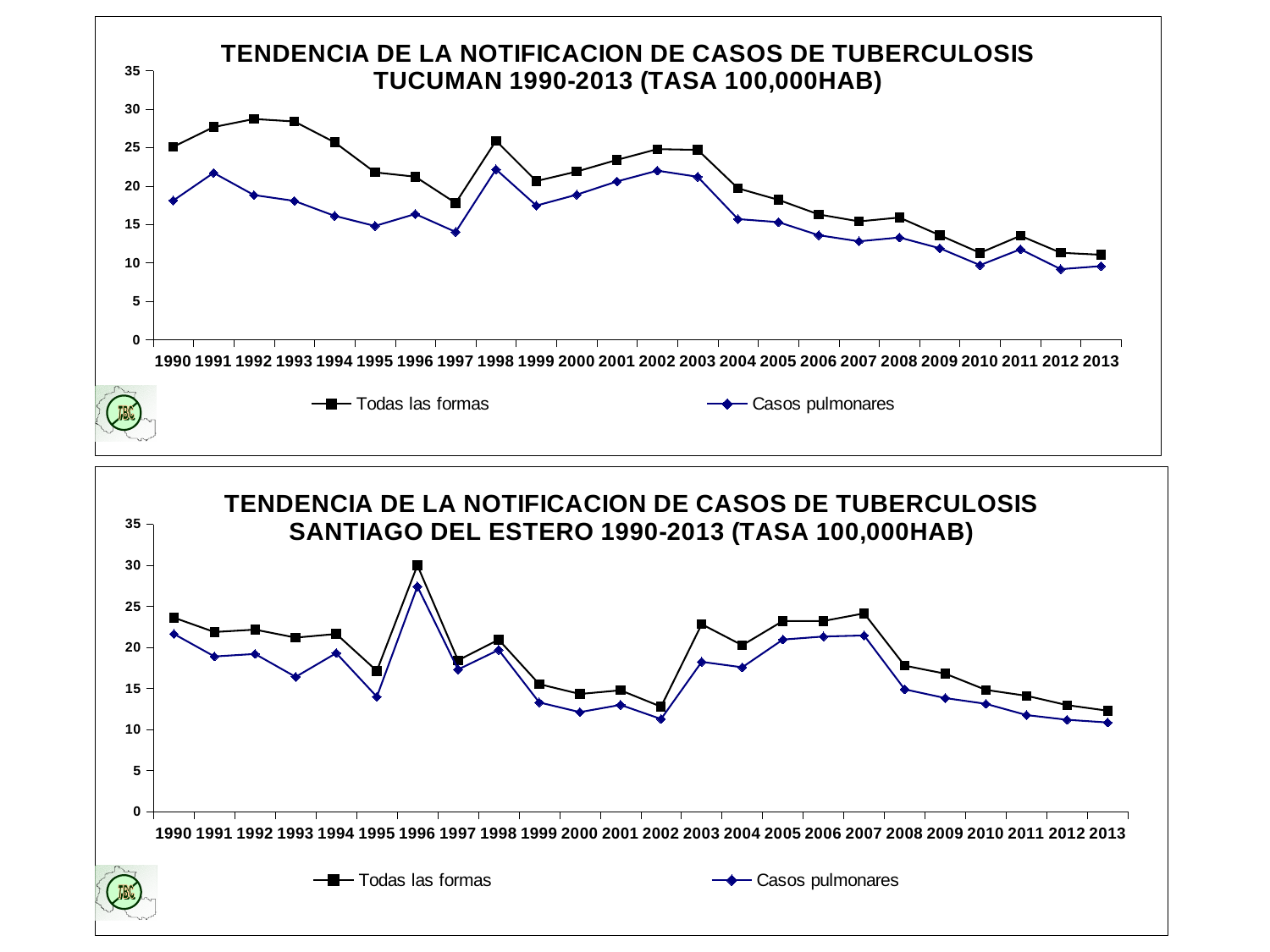
In the bottom chart (Santiago del Estero), do the values for Todas las formas rise or fall from 2007 to 2013? fall In the top chart (Tucuman), is the value for Todas las formas in 1992 greater or less than 25? greater In the top chart (Tucuman), is the value for Casos pulmonares in 1991 greater or less than 20? greater In the bottom chart (Santiago del Estero), which year has the highest value for Todas las formas? 1996 In the bottom chart (Santiago del Estero), is the value for Todas las formas in 2002 greater or less than 15? less How many series does the legend of the bottom chart (Santiago del Estero) list? 2 How many years are plotted along the x axis of the top chart (Tucuman)? 24 In the top chart (Tucuman), which is larger for Todas las formas: the value in 1992 or the value in 2013? 1992 What kind of chart is the top chart (Tucuman)? line chart In the bottom chart (Santiago del Estero), which year has the highest value for Casos pulmonares? 1996